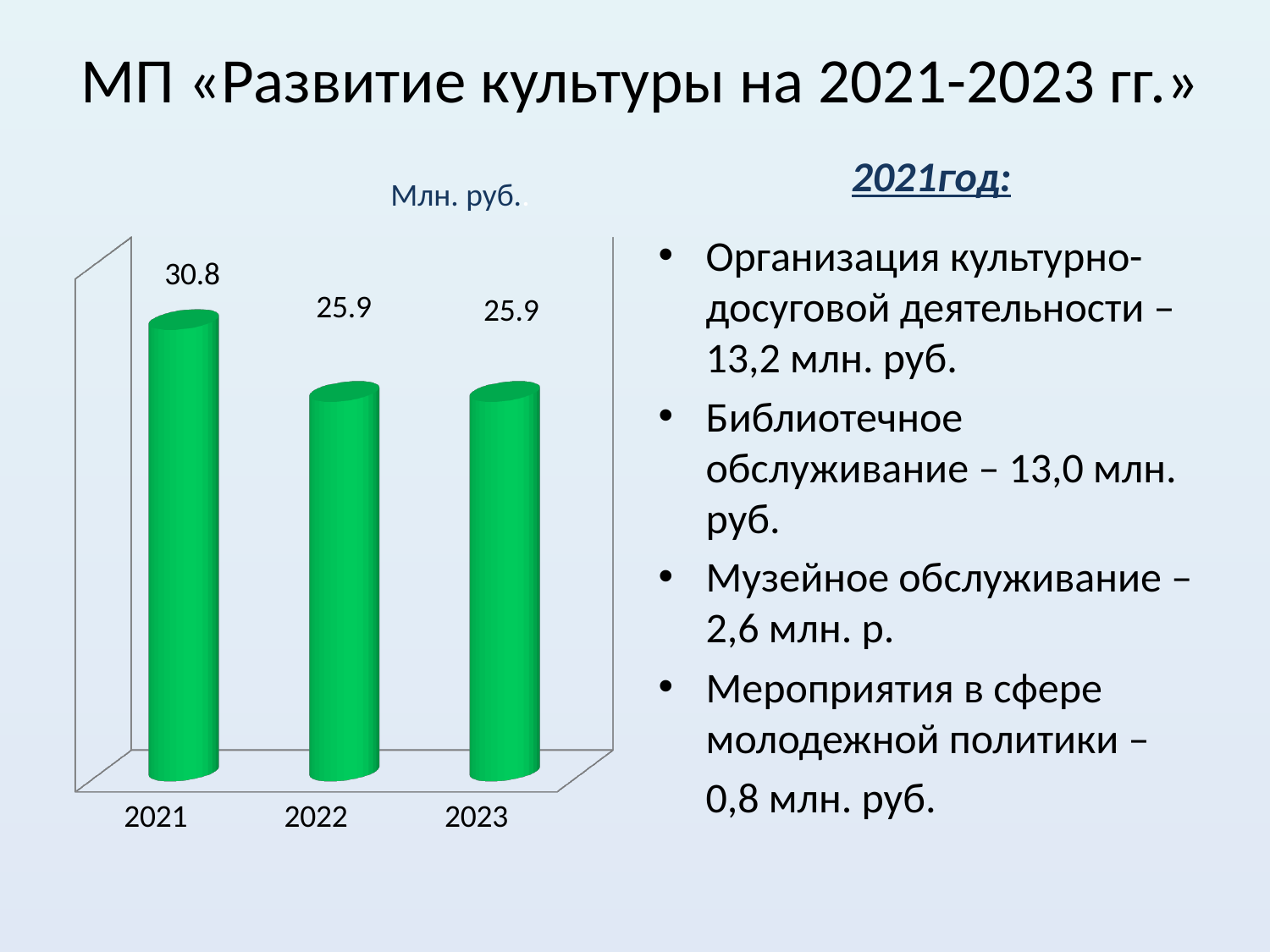
What is the value for 2023 on the chart? 25.9 What is the difference between the values for 2021 and 2022? 4.9 What is the chart's title? Млн. руб. Which year has the highest value on the chart? 2021 What kind of chart is shown on the slide? bar chart Which is larger, the value for 2021 or the value for 2023? 2021 What is the total of the values for 2022 and 2023? 51.8 What is the value for 2022 on the chart? 25.9 What colour are the bars on the chart? green What is the value for 2021 on the chart? 30.8 How many years (categories) are shown on the chart? 3 Do the values rise or fall from 2021 to 2022? fall